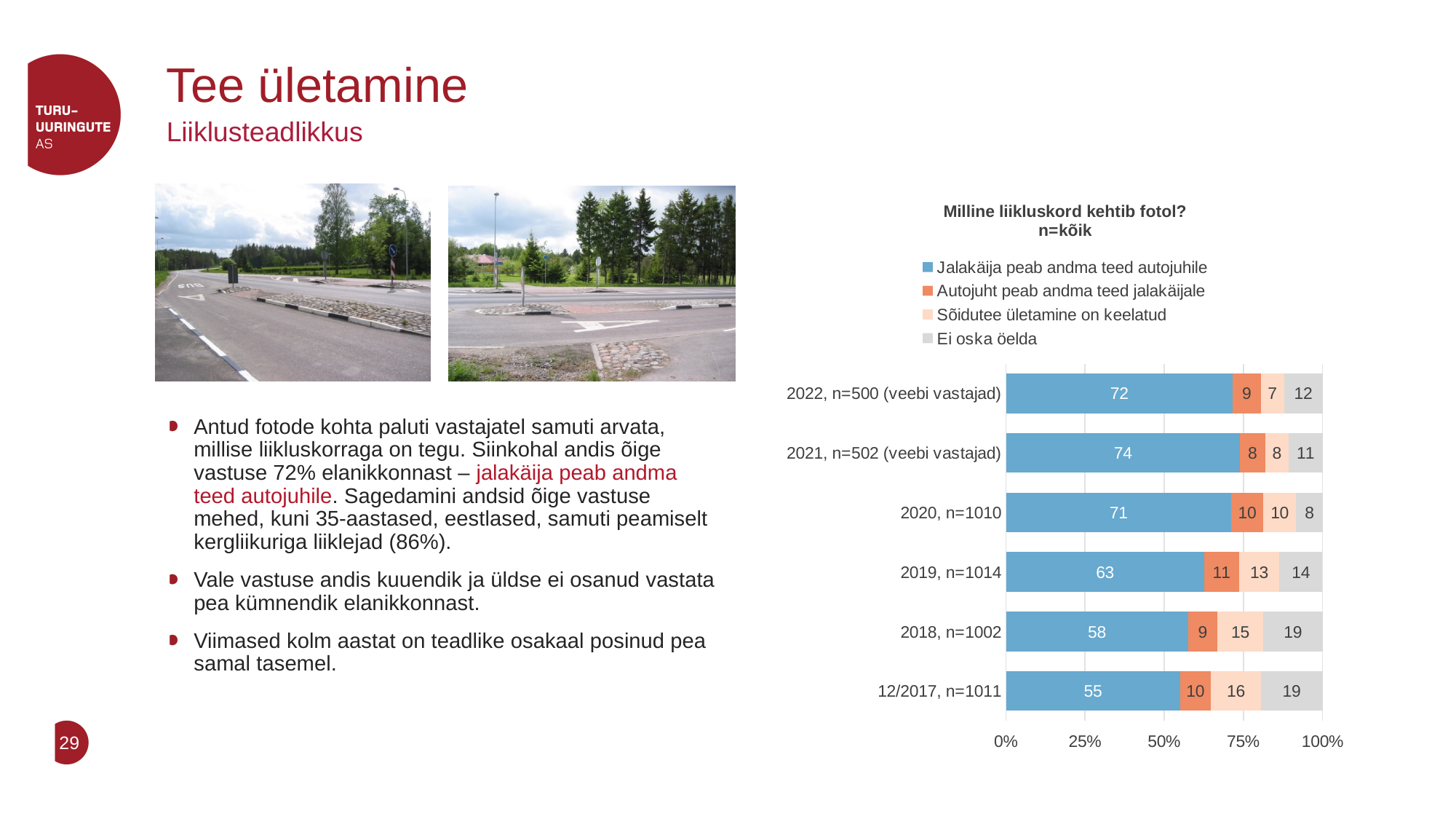
Which is larger: the "Ei oska öelda" value for 2019, n=1014 or for 2020, n=1010? 2019, n=1014 How many categories (survey waves) are shown on the chart? 6 What is the title of the chart? Milline liikluskord kehtib fotol? n=kõik What is the value for "Sõidutee ületamine on keelatud" in 2019, n=1014? 13 What is the value for "Jalakäija peab andma teed autojuhile" in 2022, n=500 (veebi vastajad)? 72 What is the value for "Ei oska öelda" in 2018, n=1002? 19 Which survey wave has the highest value for "Jalakäija peab andma teed autojuhile"? 2021, n=502 (veebi vastajad) Does the "Jalakäija peab andma teed autojuhile" value generally rise or fall from 12/2017 to 2022? Rise What is the difference between the "Jalakäija peab andma teed autojuhile" values for 2022, n=500 (veebi vastajad) and 12/2017, n=1011? 17 How many series does the chart legend list? 4 Which survey wave has the lowest value for "Jalakäija peab andma teed autojuhile"? 12/2017, n=1011 What kind of chart is shown on the slide? Stacked bar chart